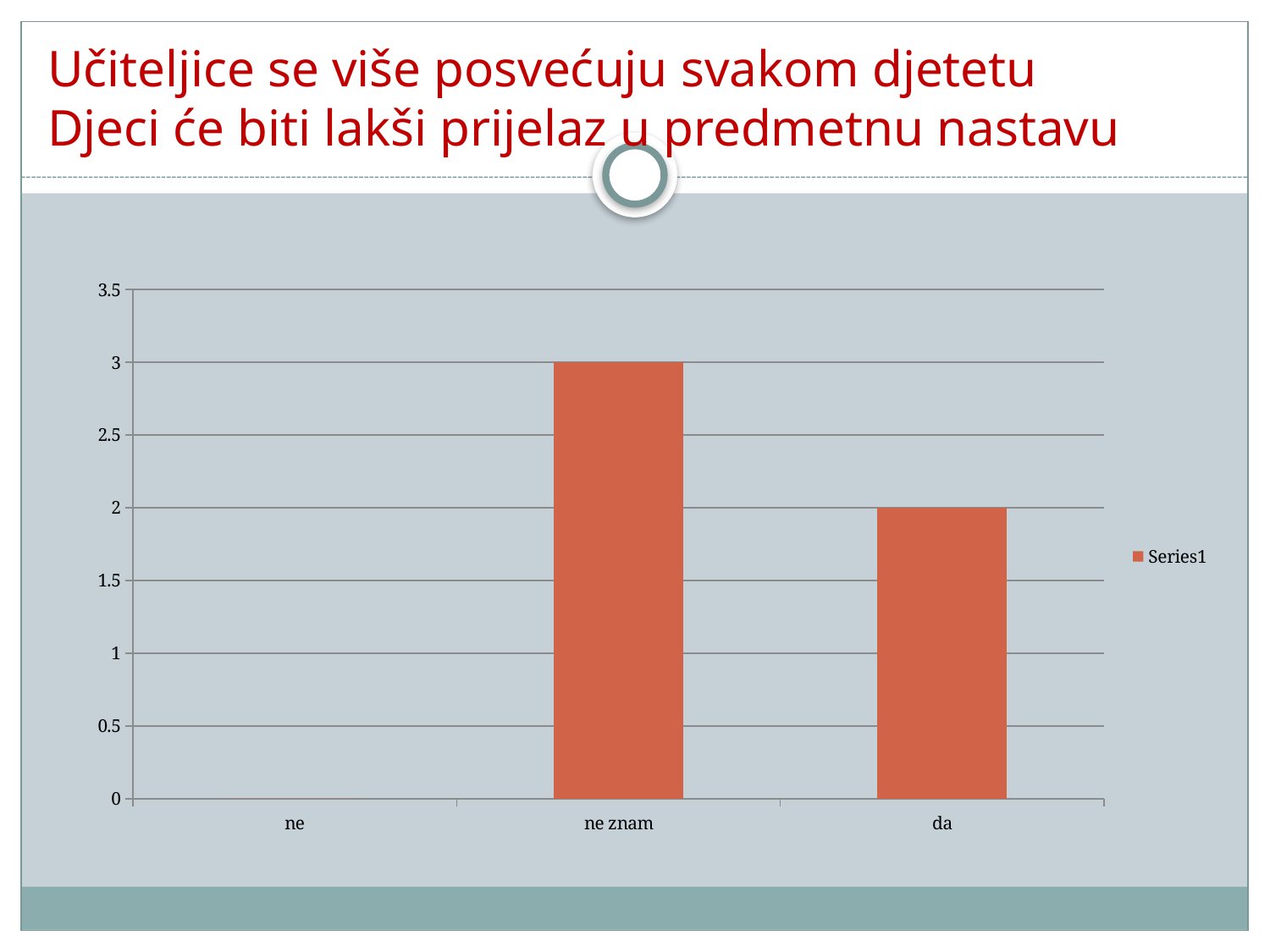
What is the difference between the values for "ne znam" and "da"? 1 How many categories are shown on the x axis of the chart? 3 How many series does the chart legend list? 1 What is the value for "ne znam"? 3 What type of chart is shown on the slide? bar chart Is the value for "da" greater or less than 2.5? less Which is larger, the value for "ne znam" or the value for "da"? ne znam Which category has the highest value? ne znam What is the value for "da"? 2 Which category has the lowest value? ne What is the name of the series shown in the legend? Series1 What is the value for "ne"? 0